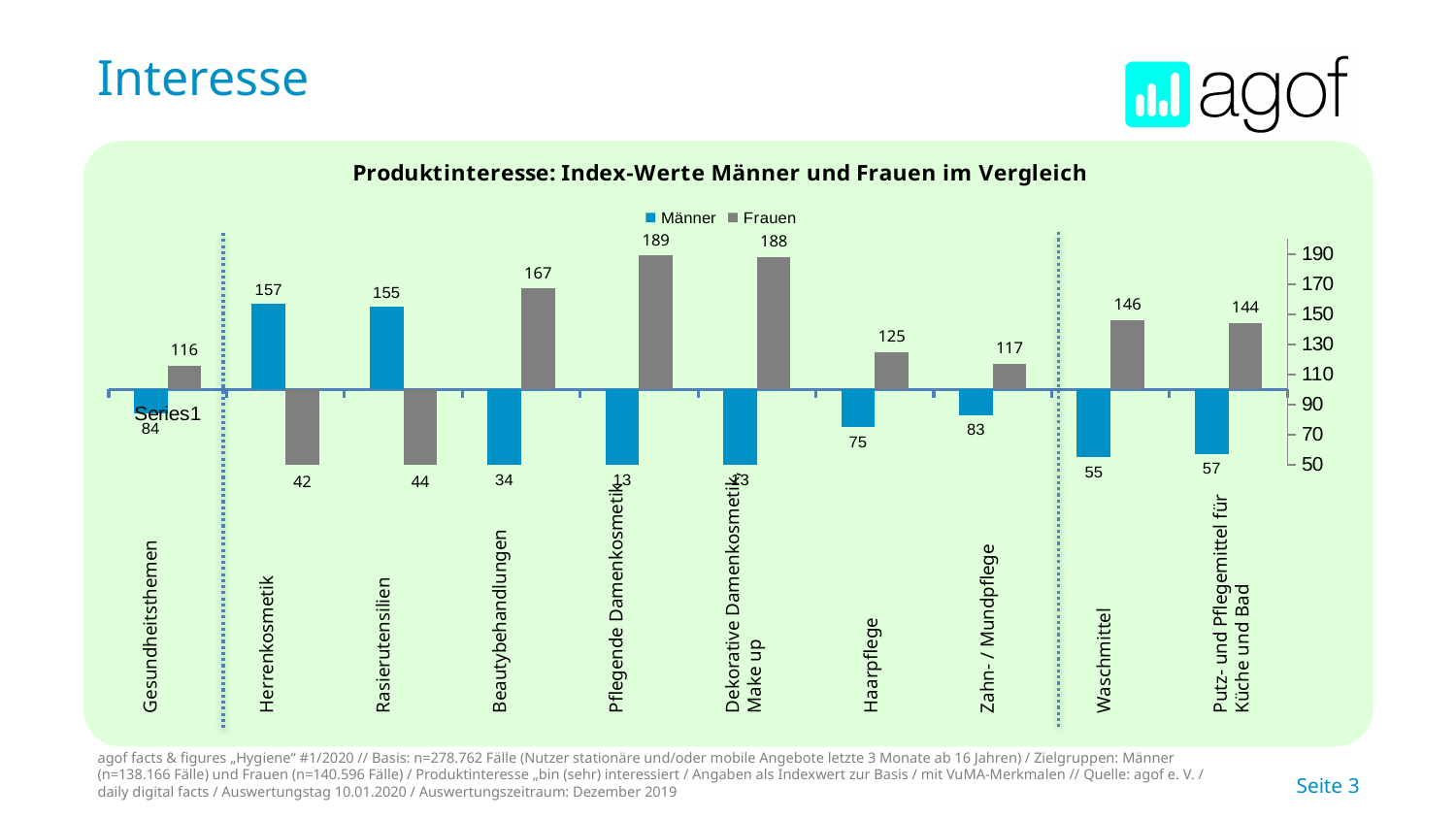
How many product categories are shown on the x axis? 10 Which has the larger Männer value, Haarpflege or Zahn- / Mundpflege? Zahn- / Mundpflege What is the Frauen index value for Putz- und Pflegemittel für Küche und Bad? 144 What is the Männer index value for Herrenkosmetik? 157 What is the difference between the Männer and Frauen values for Herrenkosmetik? 115 How many series does the legend list? 2 What is the difference between the Frauen and Männer values for Waschmittel? 91 Is the Frauen value for Waschmittel greater or less than 130? greater What kind of chart is shown on the slide? bar chart What is the Frauen index value for Beautybehandlungen? 167 For Gesundheitsthemen, which series has the larger value, Männer or Frauen? Frauen What is the Männer index value for Haarpflege? 75